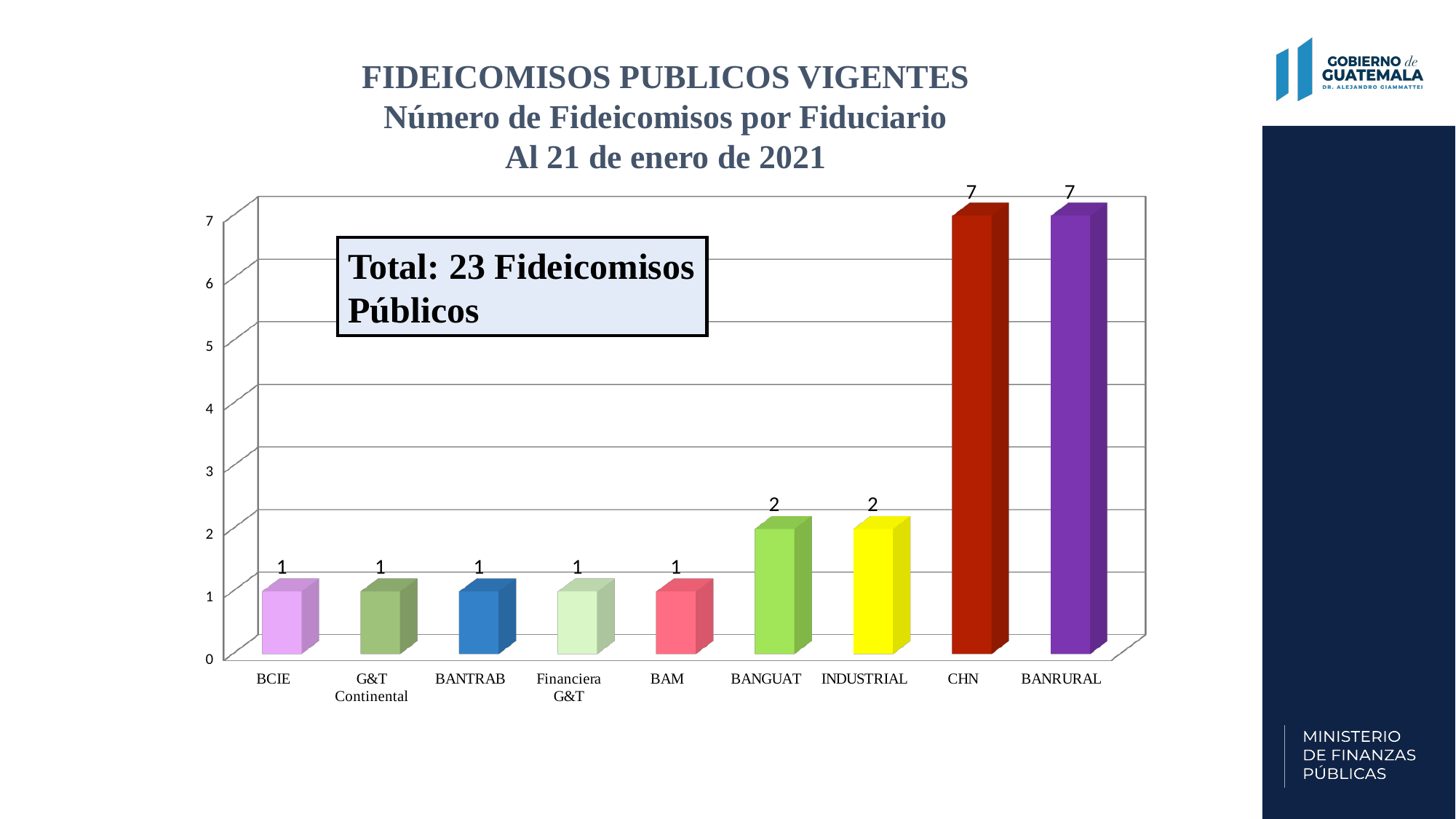
What is the value for BANGUAT? 2 What total is stated in the text box on the chart? 23 Fideicomisos Públicos What kind of chart is shown on the slide? bar chart What is the difference between the values for CHN and BANTRAB? 6 What is the difference between the values for BANRURAL and BANGUAT? 5 What date does the chart title say the data is as of? 21 de enero de 2021 Is the value for CHN greater or less than 5? greater Which is larger, the value for INDUSTRIAL or the value for BAM? INDUSTRIAL What is the value for CHN? 7 What is the value for INDUSTRIAL? 2 How many categories are shown on the x axis? 9 What is the value for BCIE? 1